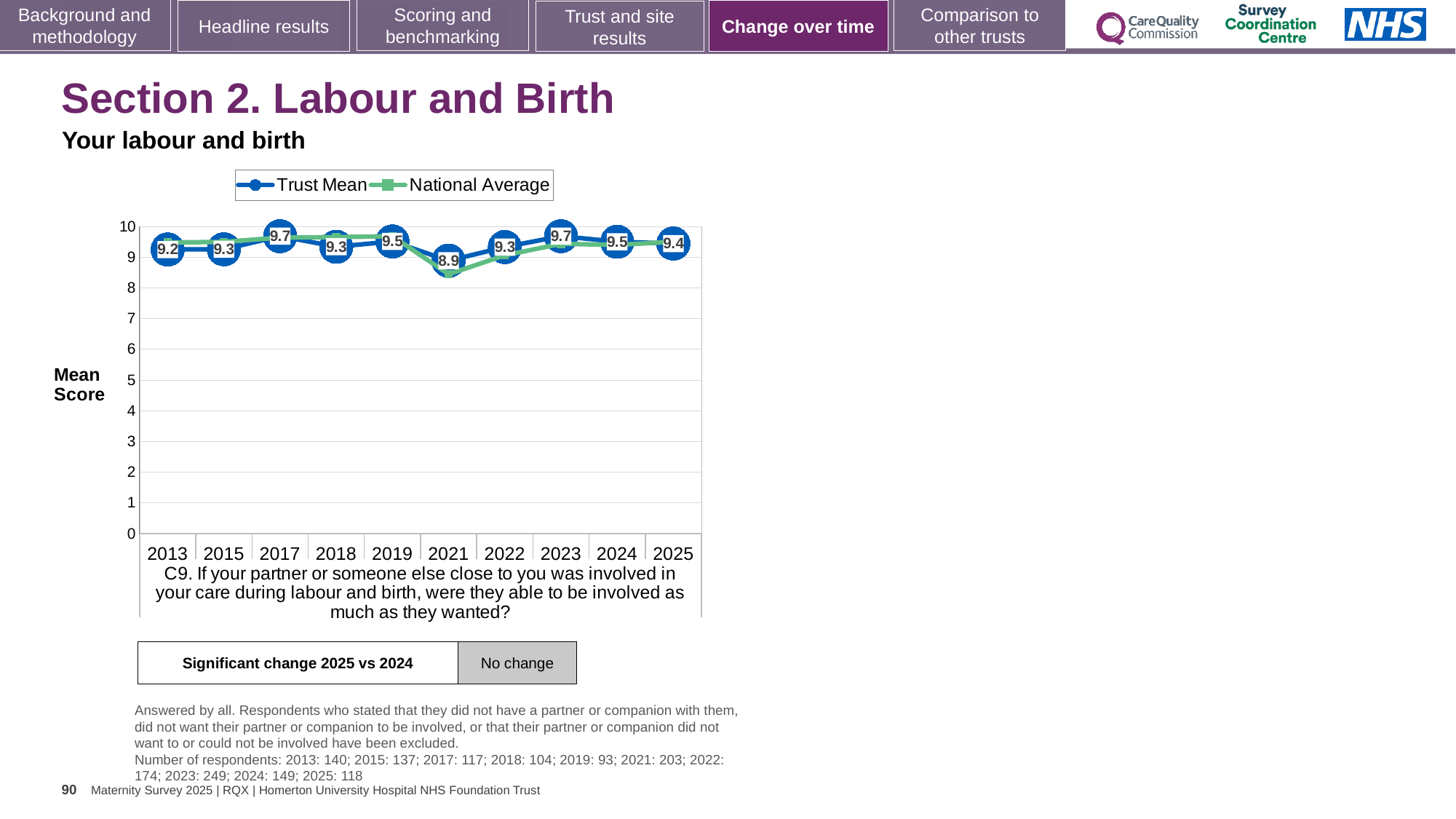
What does the box labelled 'Significant change 2025 vs 2024' say? No change What is the difference between the Trust Mean in 2023 and the Trust Mean in 2021? 0.8 What is the difference between the Trust Mean in 2024 and in 2025? 0.1 Which year has the lowest Trust Mean? 2021 How many years are shown on the x axis? 10 Is the Trust Mean for 2021 greater or less than 9? less Which is larger, the Trust Mean for 2017 or the Trust Mean for 2018? 2017 What is the Trust Mean for 2013? 9.2 What kind of chart is shown? line chart What is the Trust Mean for 2021? 8.9 What is the Trust Mean for 2025? 9.4 How many series does the legend list? 2